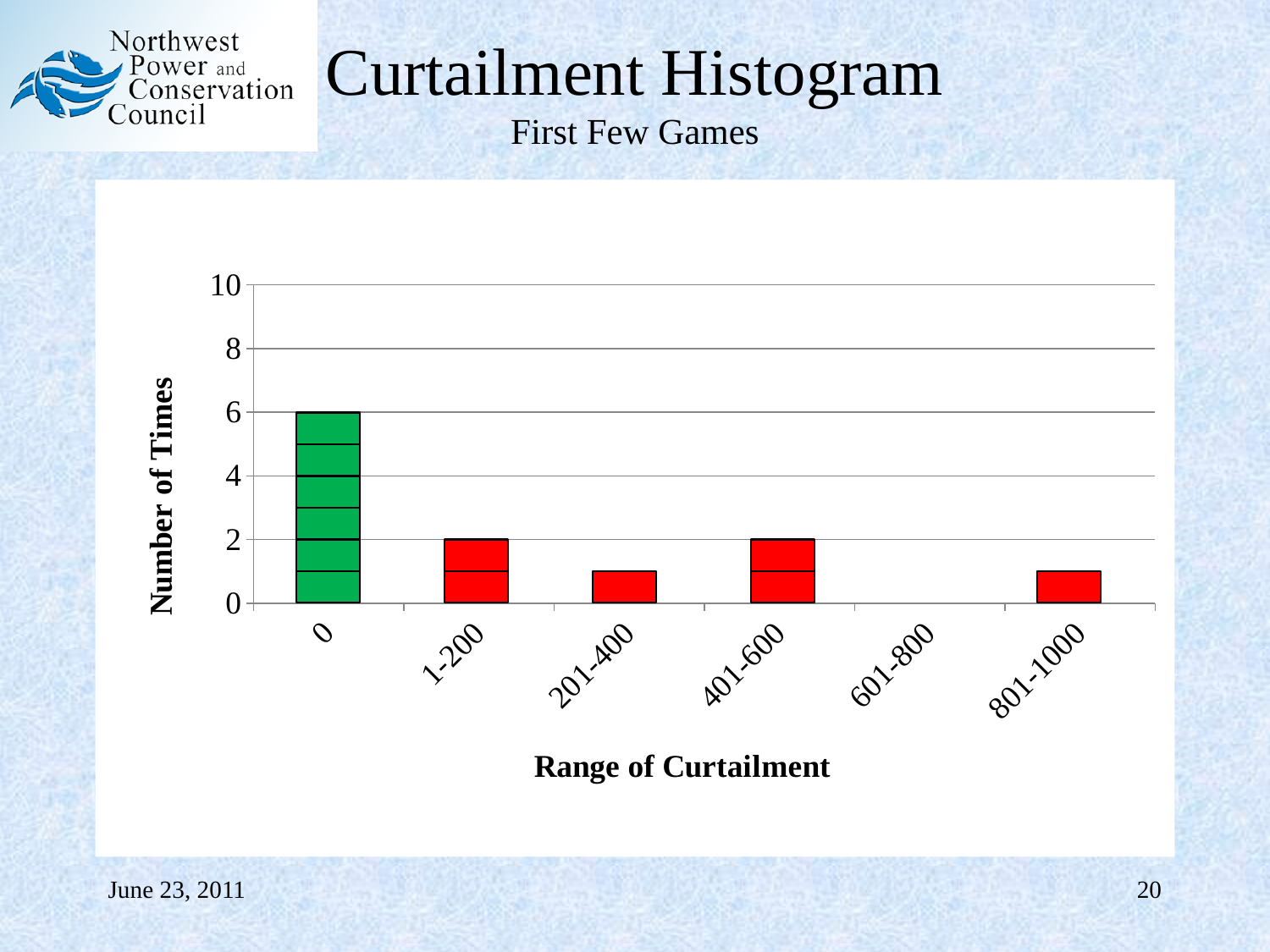
Which range of curtailment has the lowest number of times? 601-800 Is the value for the 201-400 range greater or less than 2? less What is the title of the y axis? Number of Times Which is larger, the value for the 0 range or the value for the 401-600 range? 0 What is the value for the 601-800 range of curtailment? 0 Which range of curtailment has the highest number of times? 0 What is the difference between the values for the 0 range and the 1-200 range? 4 What is the value for the 401-600 range of curtailment? 2 What kind of chart is shown on the slide? bar chart How many ranges of curtailment are shown on the x axis? 6 What is the value for the 0 range of curtailment? 6 What is the value for the 1-200 range of curtailment? 2